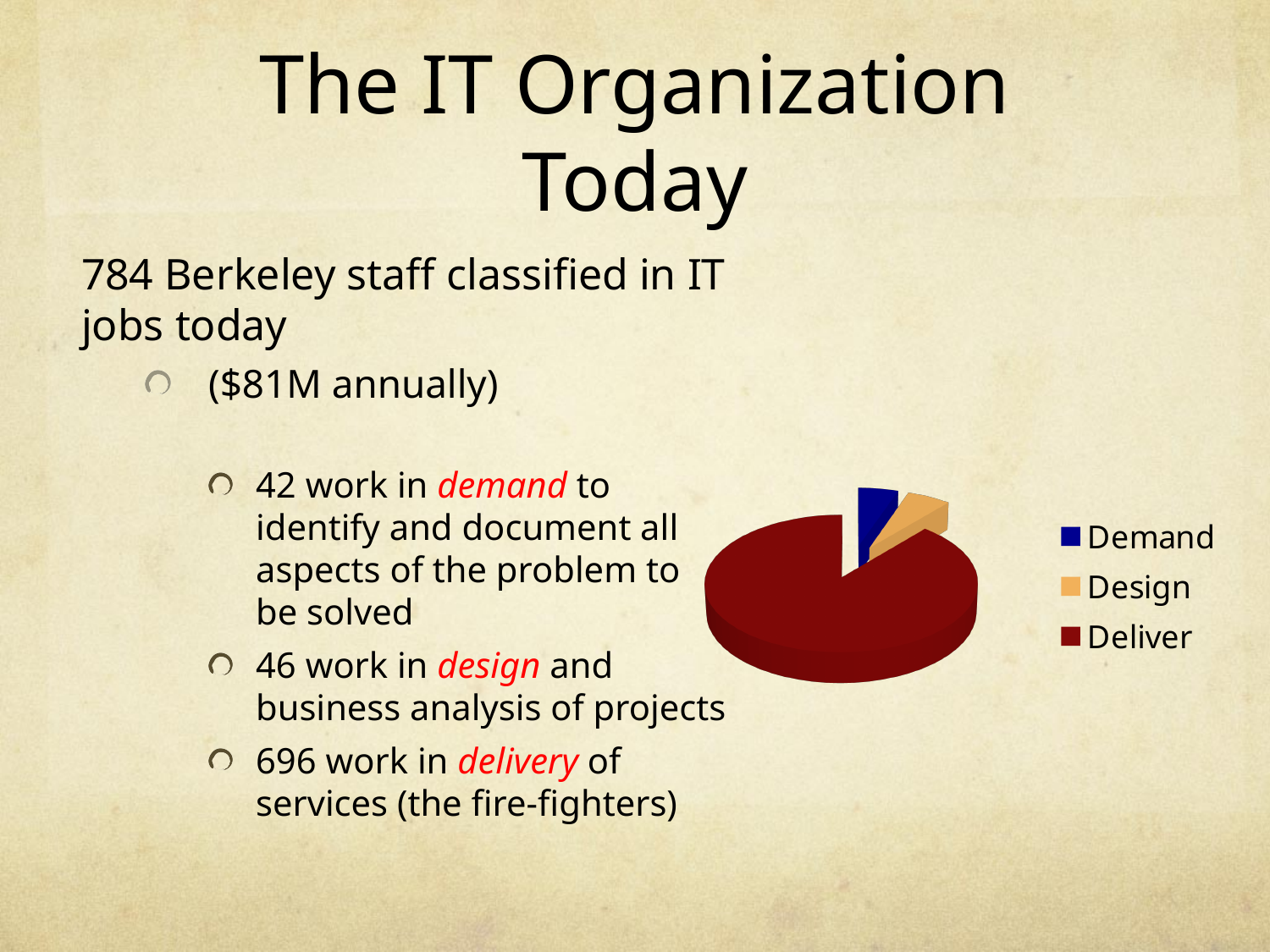
According to the slide, how many staff work in delivery of services? 696 How many entries does the pie chart's legend list? 3 Is the slice for Deliver larger or smaller than the slice for Design? larger Which legend entry is shown in blue? Demand How many more staff work in delivery than in design, according to the slide? 650 According to the slide, how many staff work in demand? 42 According to the slide, how many staff work in design? 46 Which category takes up the largest slice of the pie chart? Deliver What kind of chart is shown on the slide? pie chart What colour is the Deliver slice in the pie chart? dark red How many slices does the pie chart have? 3 Is the slice for Demand larger or smaller than the slice for Deliver? smaller